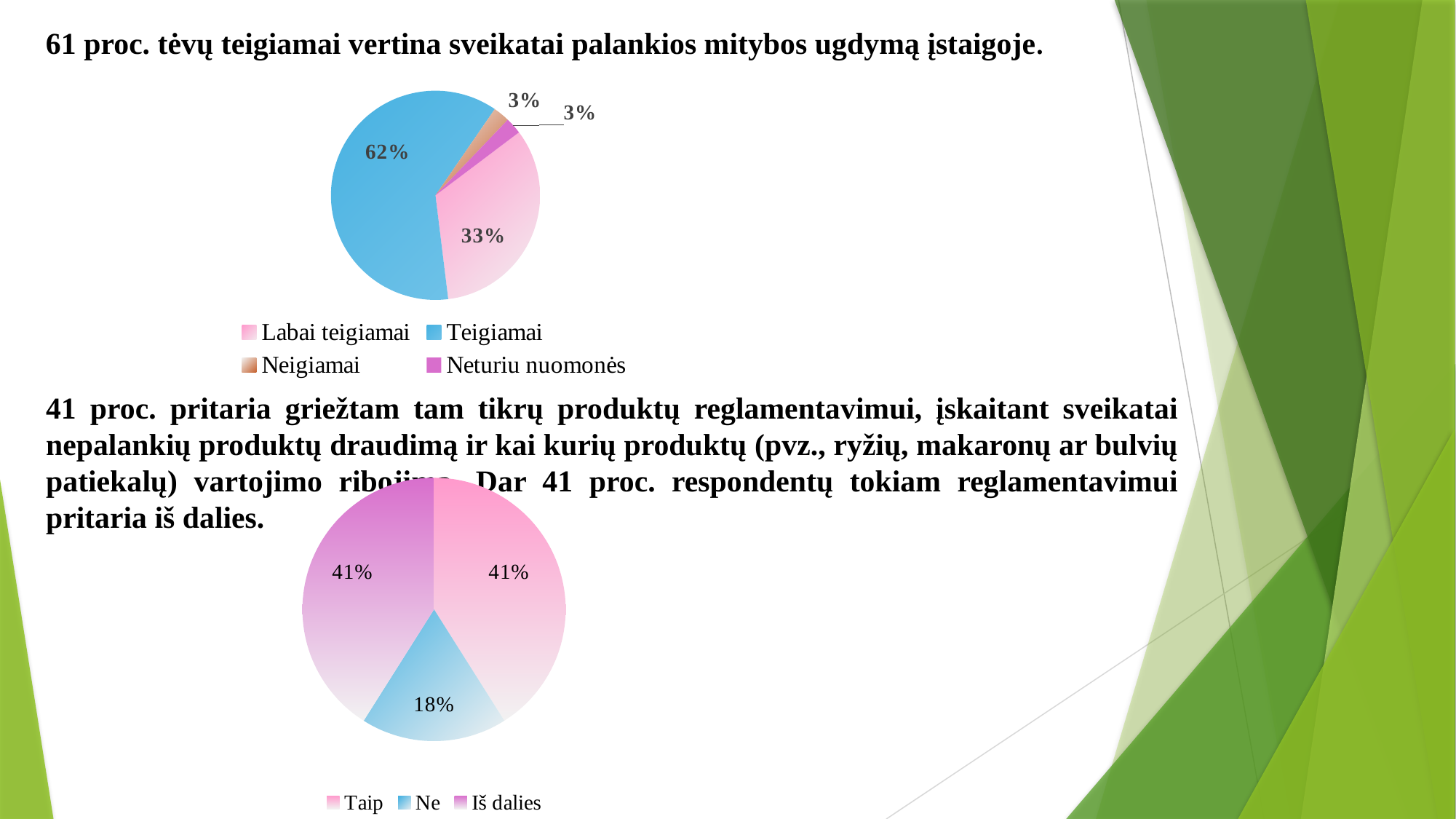
In the bottom pie chart, what share is labelled for Taip? 41% In the top pie chart, what share is labelled for Labai teigiamai? 33% In the top pie chart, what is the difference between the Teigiamai and Labai teigiamai shares? 29% How many entries does the legend of the top pie chart list? 4 In the bottom pie chart, what is the difference between the Taip and Ne shares? 23% What kind of chart is the top chart on the slide? Pie chart In the bottom pie chart, which category has the smallest slice? Ne How many categories does the bottom pie chart show? 3 In the top pie chart, which category has the largest slice? Teigiamai In the bottom pie chart, what share is labelled for Ne? 18% In the top pie chart, what share is labelled for Neigiamai? 3% In the top pie chart, what share is labelled for Teigiamai? 62%